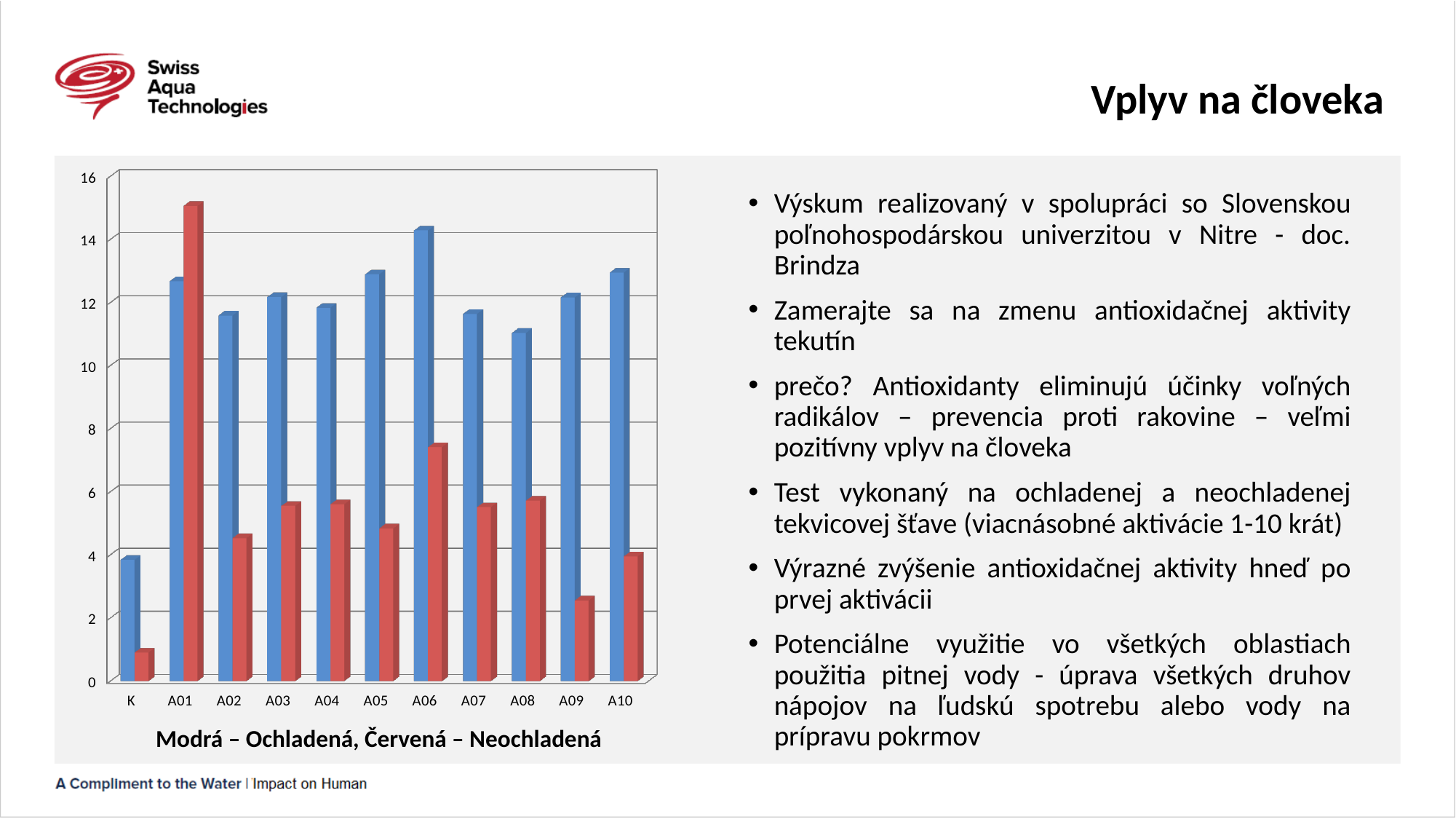
What kind of chart is shown on the slide? bar chart According to the caption under the chart, what does the blue series represent? Ochladená Which category has the highest blue (Ochladená) bar? A06 For category A01, which bar is taller, the blue (Ochladená) or the red (Neochladená)? red (Neochladená) Which category has the highest red (Neochladená) bar? A01 Is the red (Neochladená) value for K greater or less than 2? less Which category has the lowest red (Neochladená) bar? K According to the caption under the chart, what does the red series represent? Neochladená How many data series does the chart show? 2 Which category has the lowest blue (Ochladená) bar? K Is the red (Neochladená) value for A01 greater or less than 14? greater How many categories are shown along the x axis of the chart? 11